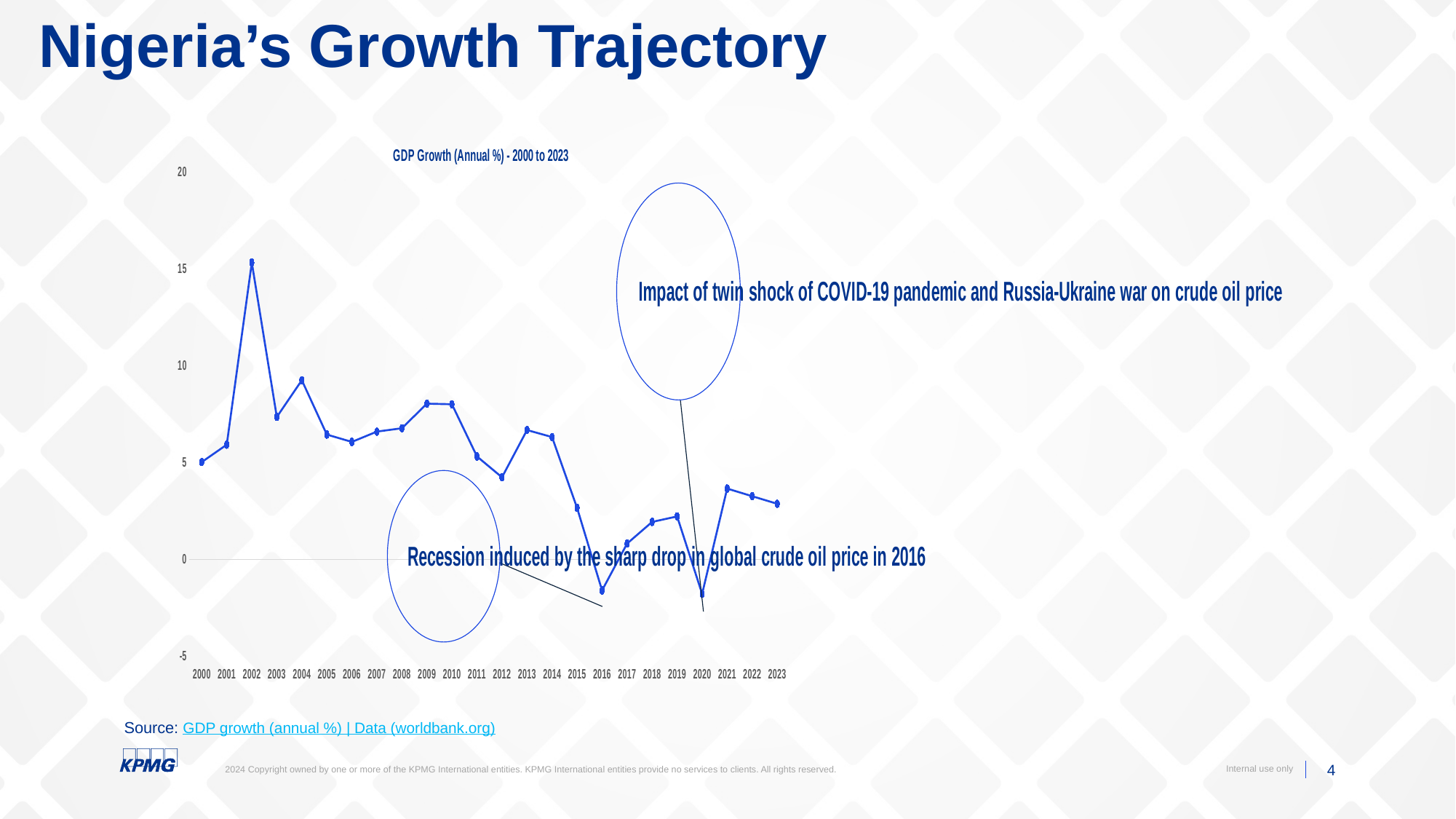
How many years are plotted on the x axis of the chart? 24 Does GDP growth rise or fall from 2013 to 2016? fall Which year has the higher GDP growth, 2002 or 2004? 2002 What kind of chart is shown on the slide? line chart Which year has the highest GDP growth in the chart? 2002 What is the title of the chart? GDP Growth (Annual %) - 2000 to 2023 Is the GDP growth value for 2012 greater or less than 5? less Is the GDP growth value for 2002 greater or less than 10? greater Is the GDP growth value for 2020 greater or less than 0? less According to the annotation, what induced the recession in 2016? the sharp drop in global crude oil price